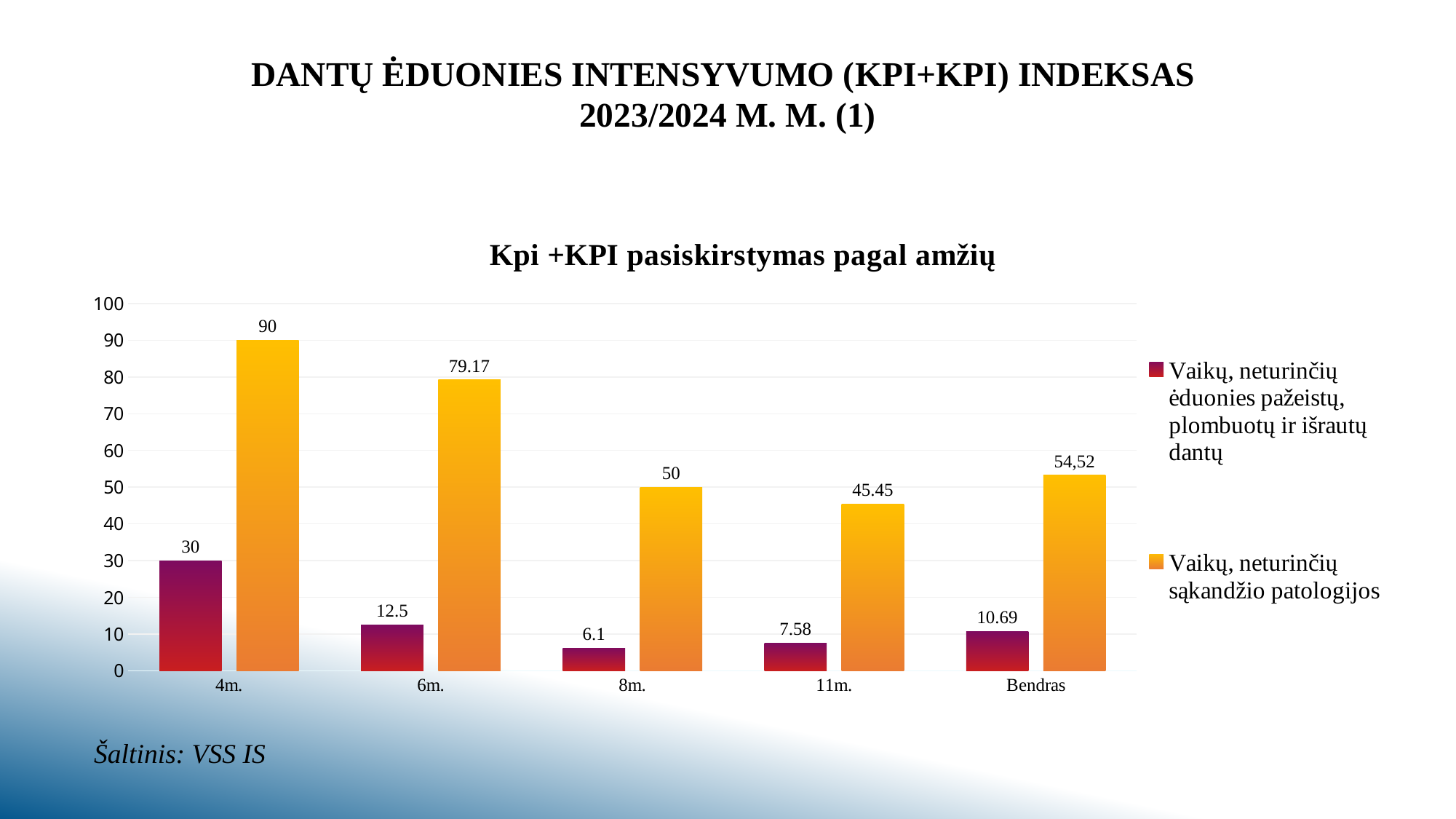
Which category has the lowest value in the series "Vaikų, neturinčių ėduonies pažeistų, plombuotų ir išrautų dantų"? 8m. What is the value for 11m. in the series "Vaikų, neturinčių ėduonies pažeistų, plombuotų ir išrautų dantų"? 7.58 What is the value for Bendras in the series "Vaikų, neturinčių sąkandžio patologijos"? 54,52 What is the difference between the two series' values for 4m.? 60 How many series does the legend list? 2 What type of chart is shown on the slide? Bar chart What is the title of the chart? Kpi +KPI pasiskirstymas pagal amžių What is the value for 8m. in the series "Vaikų, neturinčių ėduonies pažeistų, plombuotų ir išrautų dantų"? 6.1 Which category has the highest value in the series "Vaikų, neturinčių sąkandžio patologijos"? 4m. Which is larger in the series "Vaikų, neturinčių sąkandžio patologijos": 8m. or 11m.? 8m. What is the value for 4m. in the series "Vaikų, neturinčių sąkandžio patologijos"? 90 How many categories are shown on the x axis? 5